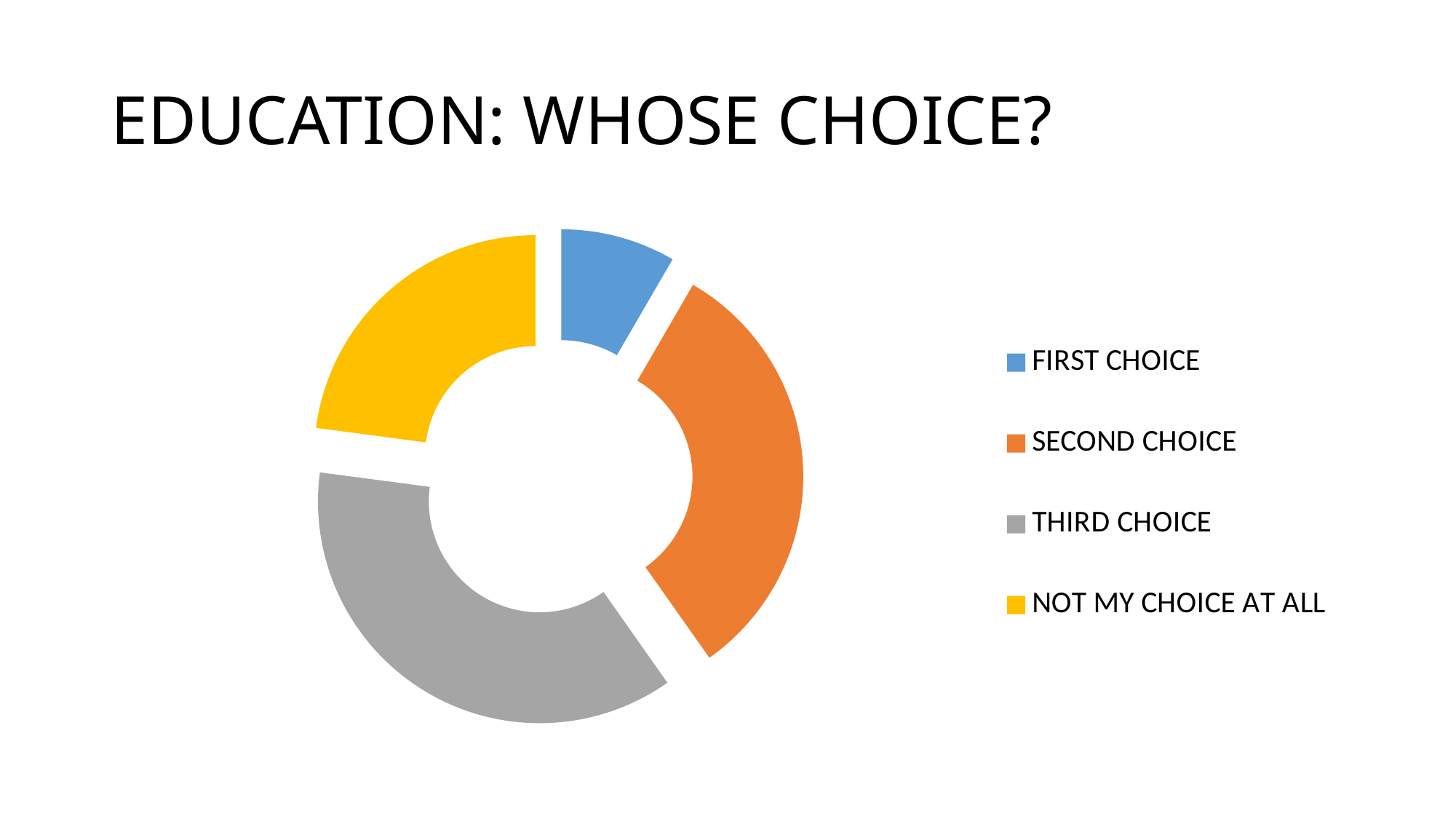
How many entries does the legend list? 4 Which slice is larger, SECOND CHOICE or FIRST CHOICE? SECOND CHOICE What colour represents THIRD CHOICE in the chart? Grey Which slice is larger, THIRD CHOICE or NOT MY CHOICE AT ALL? THIRD CHOICE What is the title of the slide? EDUCATION: WHOSE CHOICE? Which slice is larger, NOT MY CHOICE AT ALL or FIRST CHOICE? NOT MY CHOICE AT ALL How many categories does the chart show? 4 What kind of chart is shown on the slide? Doughnut (pie) chart Which category has the smallest slice? FIRST CHOICE